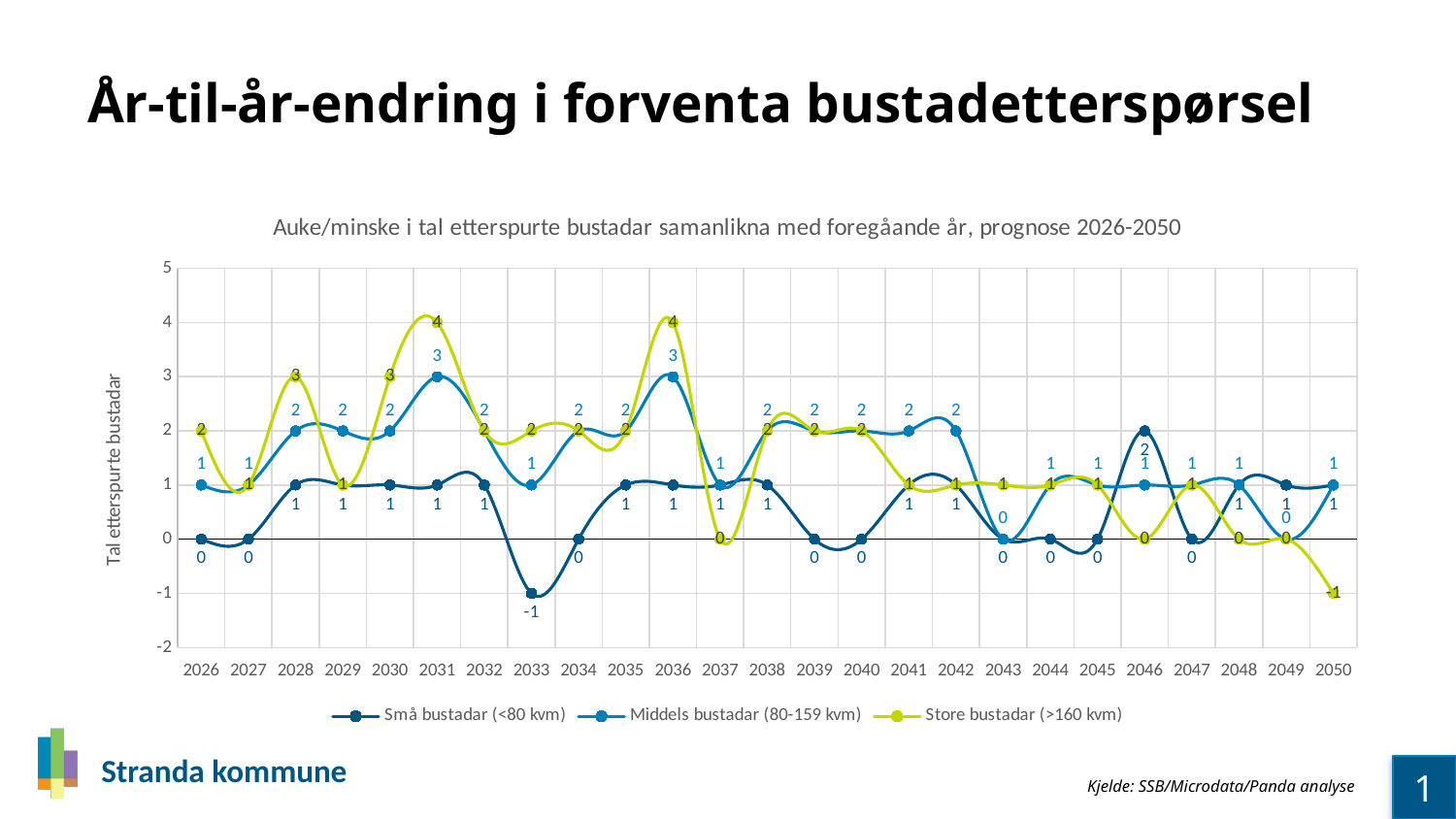
In which year does Store bustadar (>160 kvm) reach its lowest value? 2050 What is the value for Middels bustadar (80-159 kvm) in 2036? 3 How many years are plotted along the x axis? 25 In 2036, which series has the larger value: Store bustadar (>160 kvm) or Middels bustadar (80-159 kvm)? Store bustadar (>160 kvm) What is the value for Små bustadar (<80 kvm) in 2033? -1 What is the value for Store bustadar (>160 kvm) in 2050? -1 In which year does Små bustadar (<80 kvm) reach its highest value? 2046 In 2031, what is the difference between the value for Store bustadar (>160 kvm) and the value for Små bustadar (<80 kvm)? 3 What is the value for Store bustadar (>160 kvm) in 2031? 4 What is the title of the vertical axis? Tal etterspurte bustadar How many series does the legend list? 3 What kind of chart is shown on the slide? Line chart